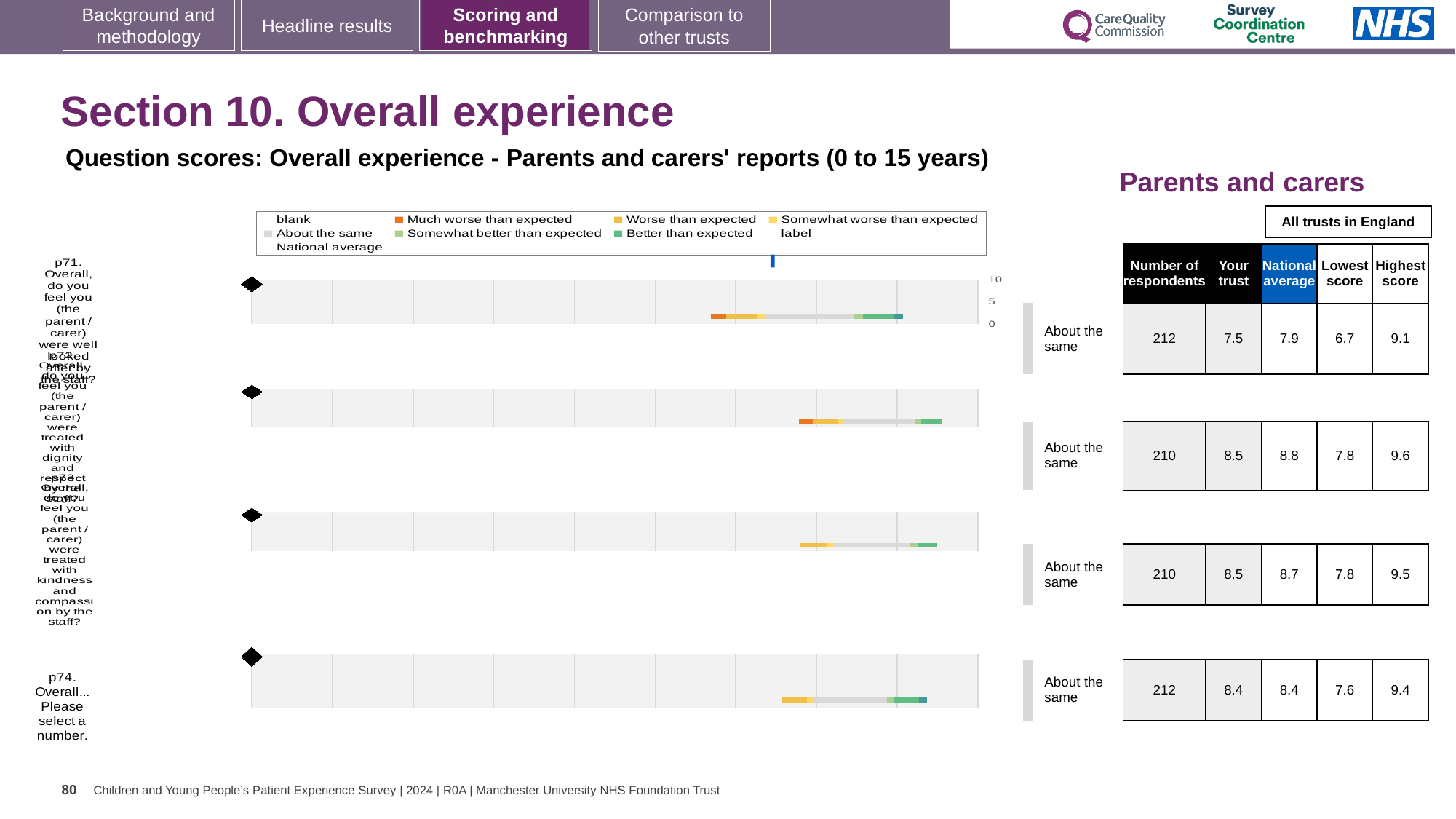
What is the lowest score across all trusts for p74? 7.6 What is the difference between the national average and the 'Your trust' score for p71? 0.4 How many respondents answered p74 (Overall... Please select a number)? 212 What is the highest score across all trusts for the second question row? 9.6 Is the 'Your trust' score for p71 higher or lower than the national average? lower What colour represents 'Much worse than expected' in the legend? orange Which question row has the lowest 'Your trust' score? p71 How many question rows (charts) are plotted on the slide? 4 What is the national average score for p71? 7.9 What is the 'Your trust' score for p71 (Overall, do you feel you were well looked after by the staff?)? 7.5 What type of chart is used for each question row? bar chart